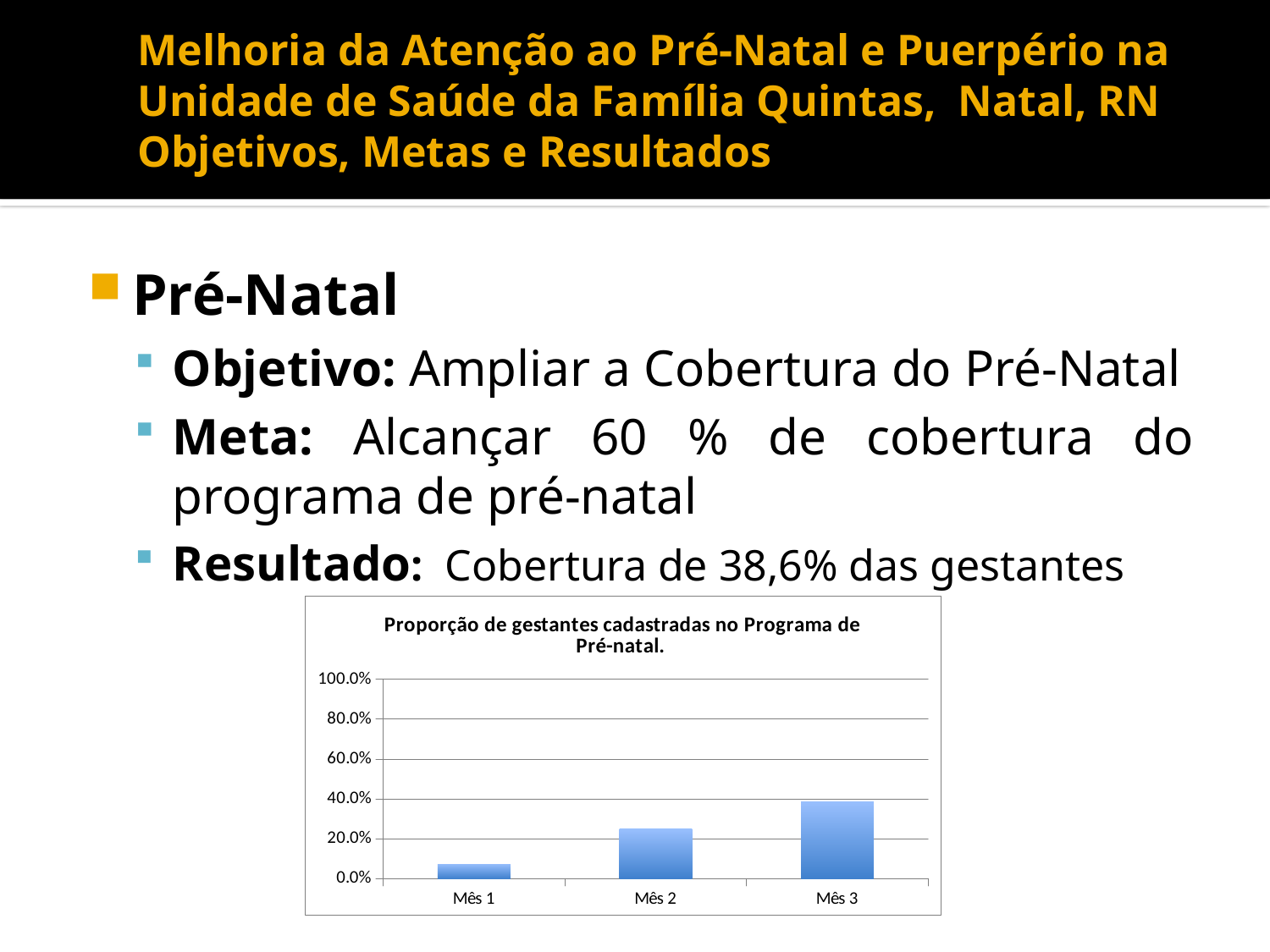
What is the title of the chart? Proporção de gestantes cadastradas no Programa de Pré-natal. Is the value for Mês 2 greater or less than 20.0%? greater Is the value for Mês 3 greater or less than 60.0%? less Do the values rise or fall from Mês 1 to Mês 3? rise Which month has the lowest proportion of registered pregnant women? Mês 1 Is the value for Mês 1 greater or less than 20.0%? less Which is larger, the value for Mês 2 or the value for Mês 3? Mês 3 How many categories (months) are plotted in the chart? 3 What kind of chart is shown on the slide? bar chart What is the highest value shown on the chart's vertical axis? 100.0% Which month has the highest proportion of registered pregnant women? Mês 3